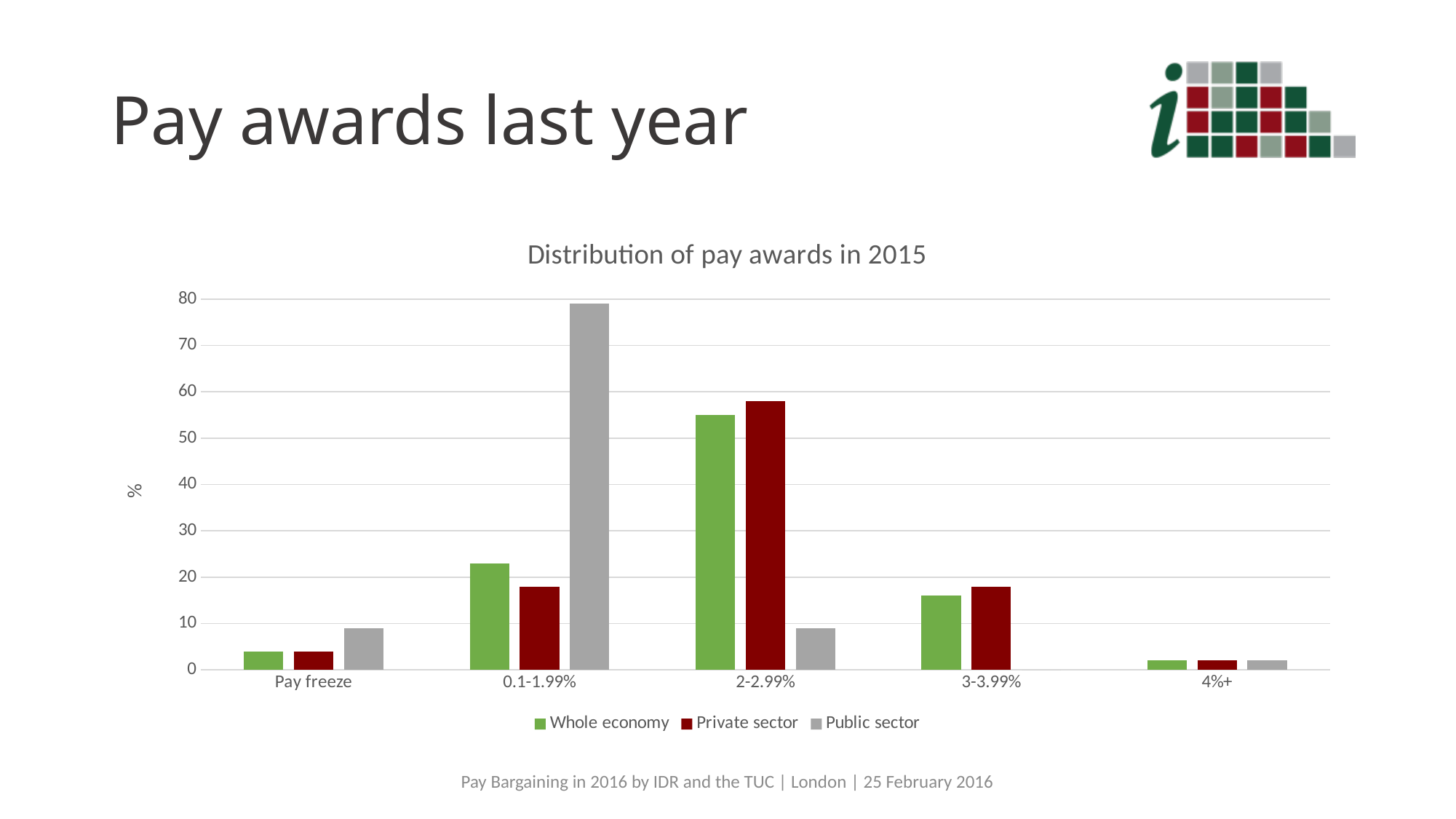
Is the Public sector value for 0.1-1.99% greater or less than 70? greater What kind of chart is shown on the slide? Bar chart For the 0.1-1.99% category, which is larger: Whole economy or Private sector? Whole economy For the 0.1-1.99% category, which is larger: Public sector or Whole economy? Public sector Is the Whole economy value for 0.1-1.99% greater or less than 20? greater What is the title of the chart? Distribution of pay awards in 2015 Is the Whole economy value for 2-2.99% greater or less than 50? greater How many series does the legend list? 3 Which category has the highest Whole economy value? 2-2.99% Which category has the highest Public sector value? 0.1-1.99% How many pay award categories are shown on the x axis? 5